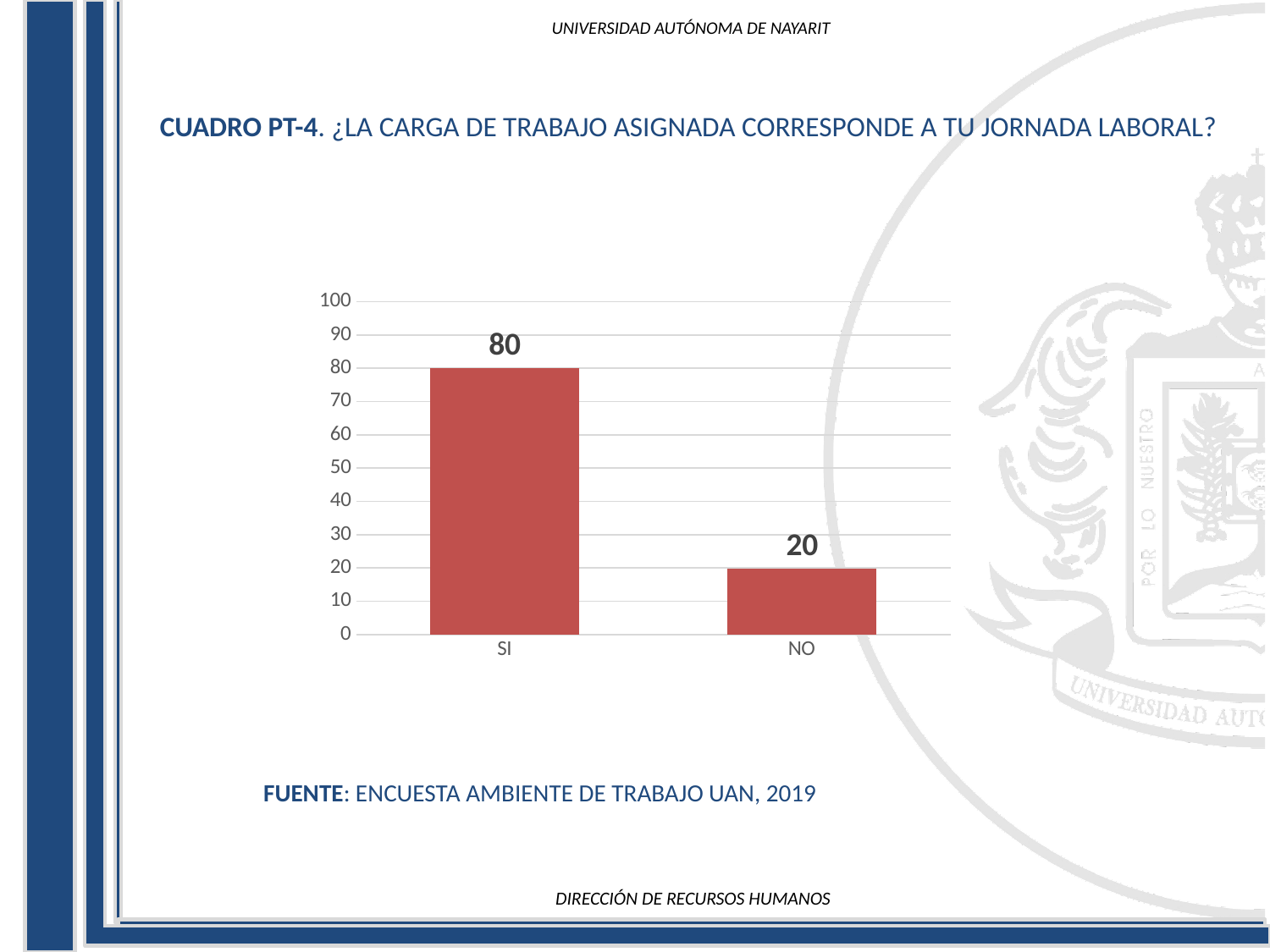
Which category has the highest value? SI Which category has the lowest value? NO What is the value for SI? 80 What is the value for NO? 20 What is the difference between the values for SI and NO? 60 Is the value for NO greater or less than 50? less How many categories are shown on the x axis? 2 Is the value for SI greater or less than 70? greater What kind of chart is shown on the slide? bar chart What is the maximum value shown on the vertical axis? 100 What is the total of the values for SI and NO? 100 Which is larger, the value for SI or the value for NO? SI